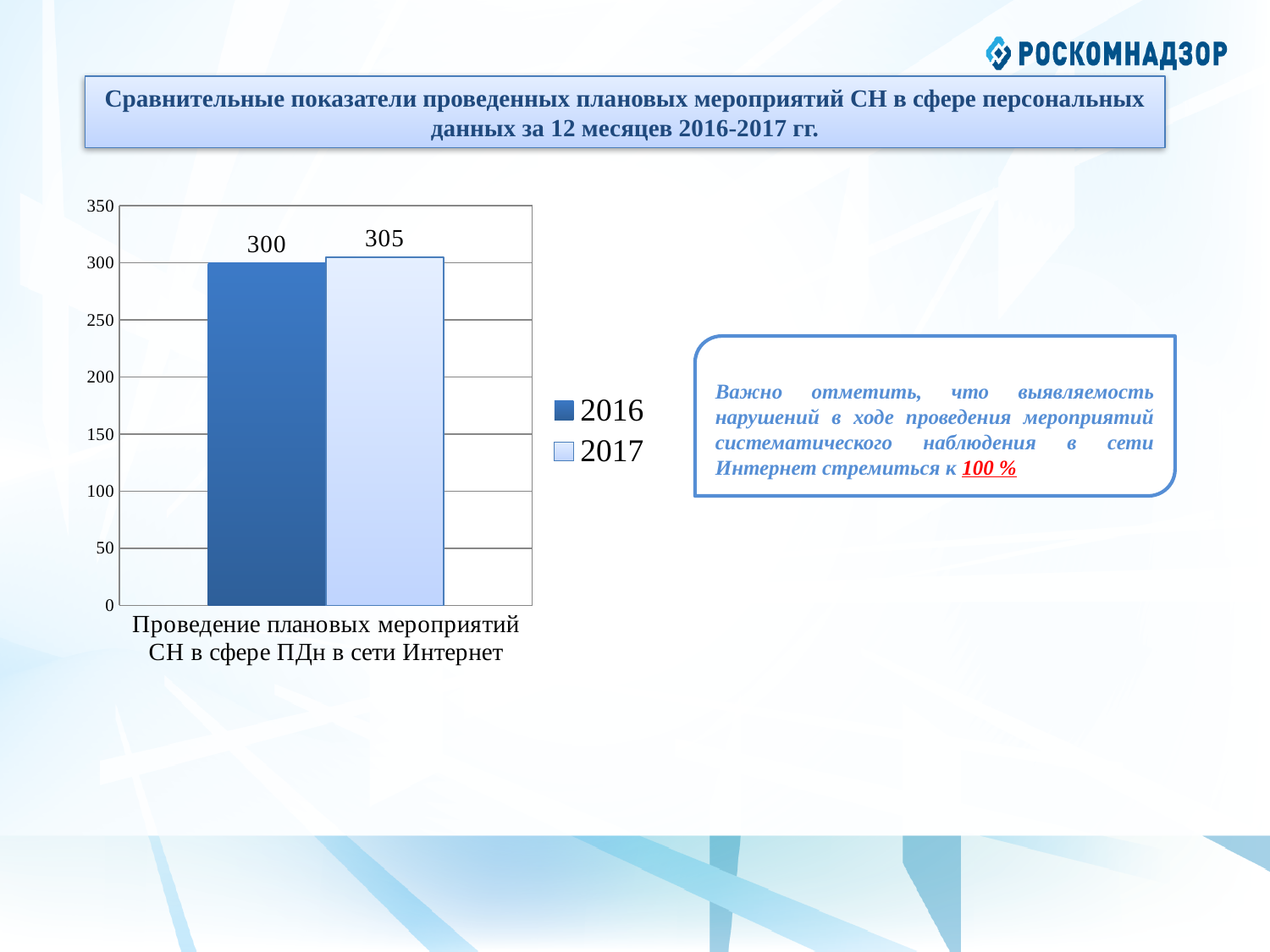
Did the value rise or fall from 2016 to 2017? rise Is the value for 2017 greater or less than 350? less What is the value for 2016 in the chart? 300 What is the value for 2017 in the chart? 305 What kind of chart is shown on the slide? bar chart Is the value for 2016 greater or less than 250? greater What is the maximum value shown on the vertical axis of the chart? 350 Which series is shown in the darker blue colour in the chart? 2016 How many series does the legend list? 2 How many categories are shown on the x axis of the chart? 1 What is the difference between the 2017 and 2016 values? 5 Which series has the higher value, 2016 or 2017? 2017